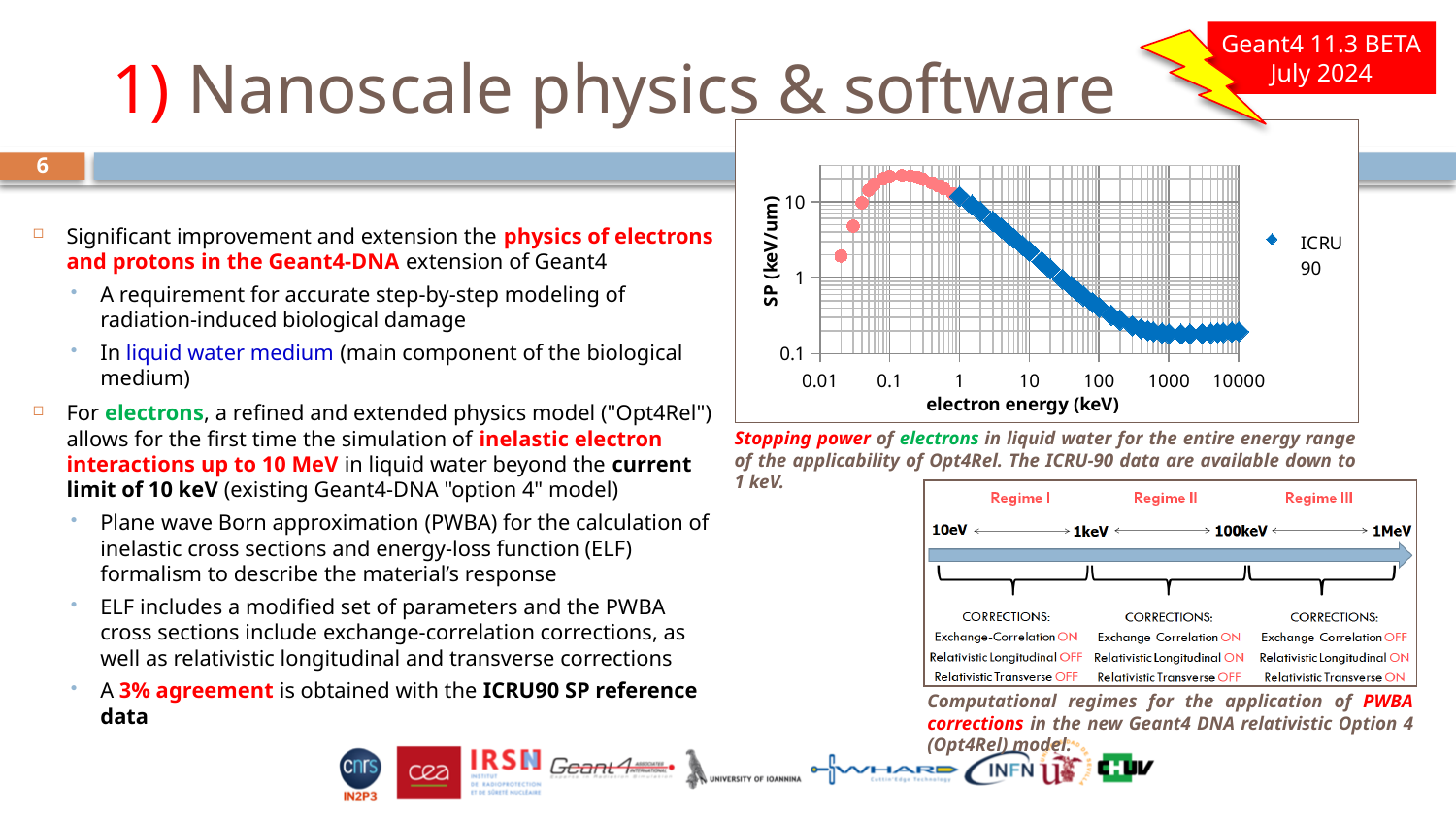
What kind of chart is shown on the slide? scatter chart Between electron energies of 0.01 keV and 0.1 keV, do the SP values rise or fall as energy increases? rise Is the SP value at an electron energy of 0.1 keV greater or less than 10? greater Between electron energies of 1 keV and 100 keV, do the SP values rise or fall as energy increases? fall What is the highest tick value shown on the x axis of the chart? 10000 What is the label of the y axis of the chart? SP (keV/um) Is the SP value at an electron energy of 1000 keV greater or less than 1? less How many series does the chart's legend list? 1 Is the SP value at an electron energy of 10 keV greater or less than 1? greater What is the label of the x axis of the chart? electron energy (keV) Which is larger, the SP value at 1 keV or the SP value at 100 keV? 1 keV